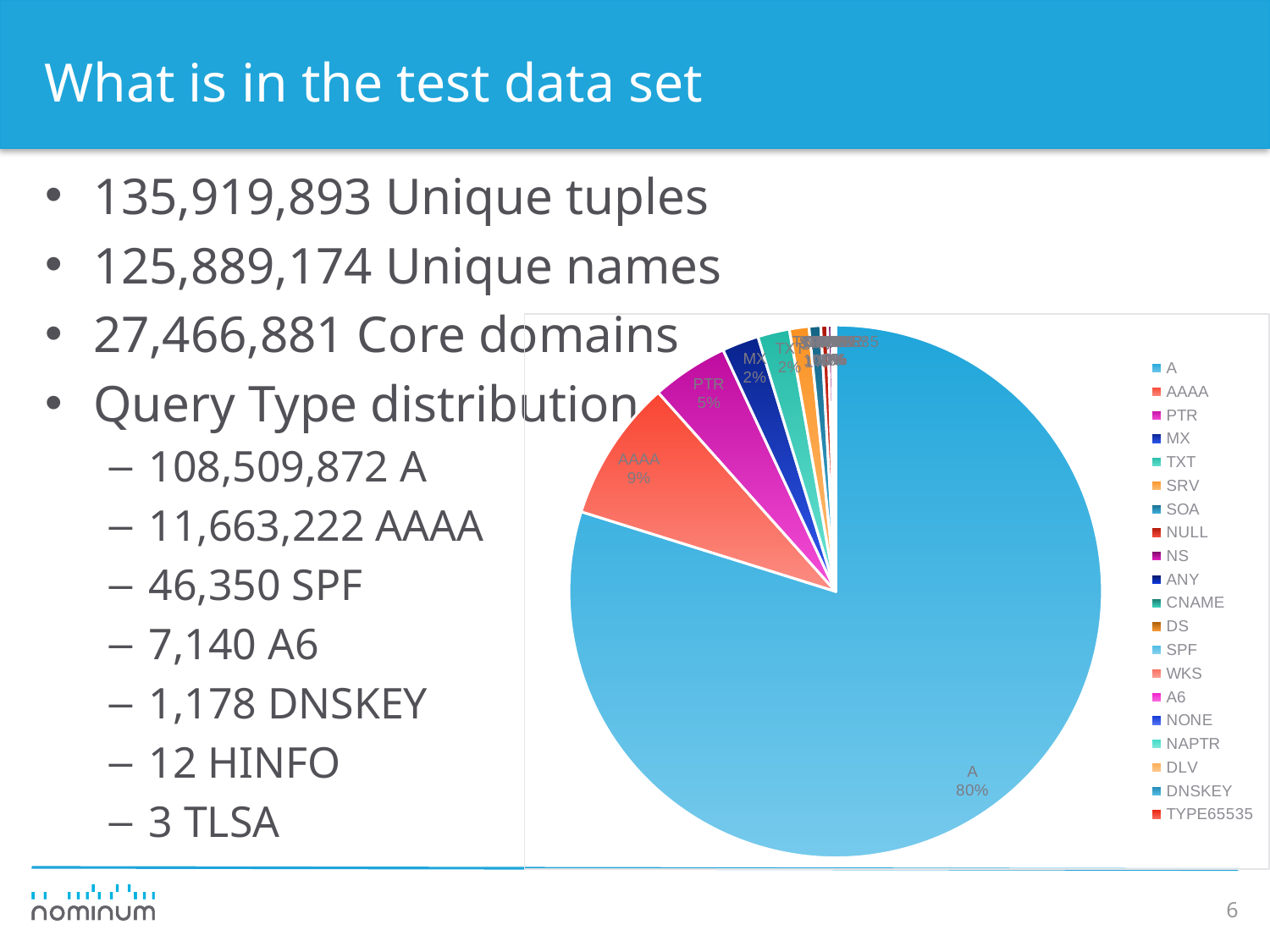
What kind of chart is shown on the slide? pie chart What share of the pie does the A slice represent? 80% What is the difference in percentage points between the A slice and the AAAA slice? 71 How many entries does the pie chart's legend list? 20 Which query type has the largest slice of the pie? A What is the last entry in the pie chart's legend? TYPE65535 Which slice is larger, AAAA or PTR? AAAA Which slice is larger, PTR or MX? PTR What share of the pie does the MX slice represent? 2% What is the first entry in the pie chart's legend? A What share of the pie does the PTR slice represent? 5%